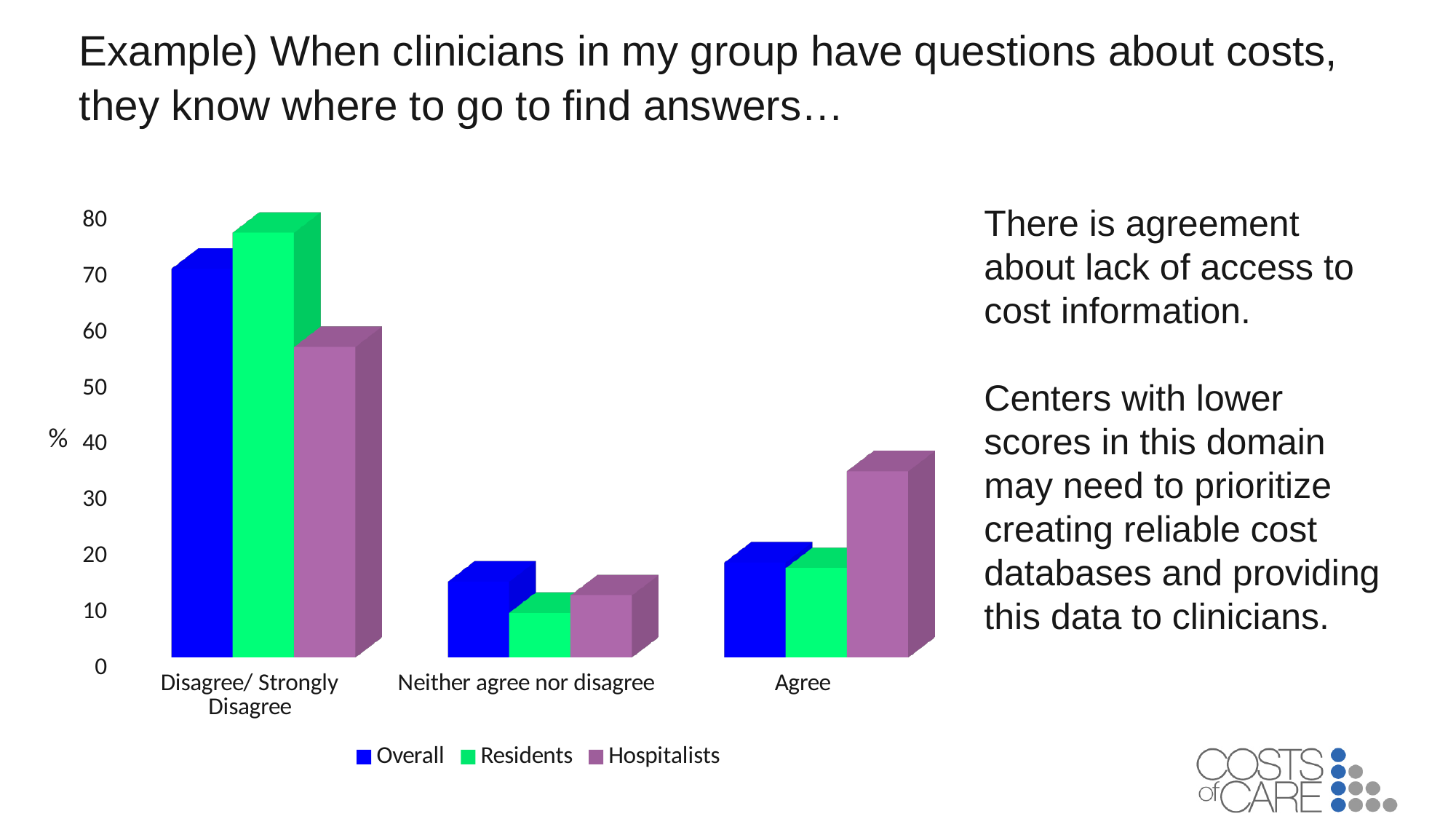
Which series has the highest value in the Agree category? Hospitalists Is the Overall value for Neither agree nor disagree greater or less than 10? greater For Hospitalists, which is larger: the value for Disagree/ Strongly Disagree or the value for Agree? Disagree/ Strongly Disagree Which series has the lowest value in the Neither agree nor disagree category? Residents What kind of chart is shown on the slide? bar chart How many categories are shown on the x axis of the chart? 3 Which series has the highest value in the Disagree/ Strongly Disagree category? Residents Is the Hospitalists value for Disagree/ Strongly Disagree greater or less than 60? less How many series does the chart's legend list? 3 Is the Residents value for Disagree/ Strongly Disagree greater or less than 70? greater What label is shown on the vertical axis of the chart? %